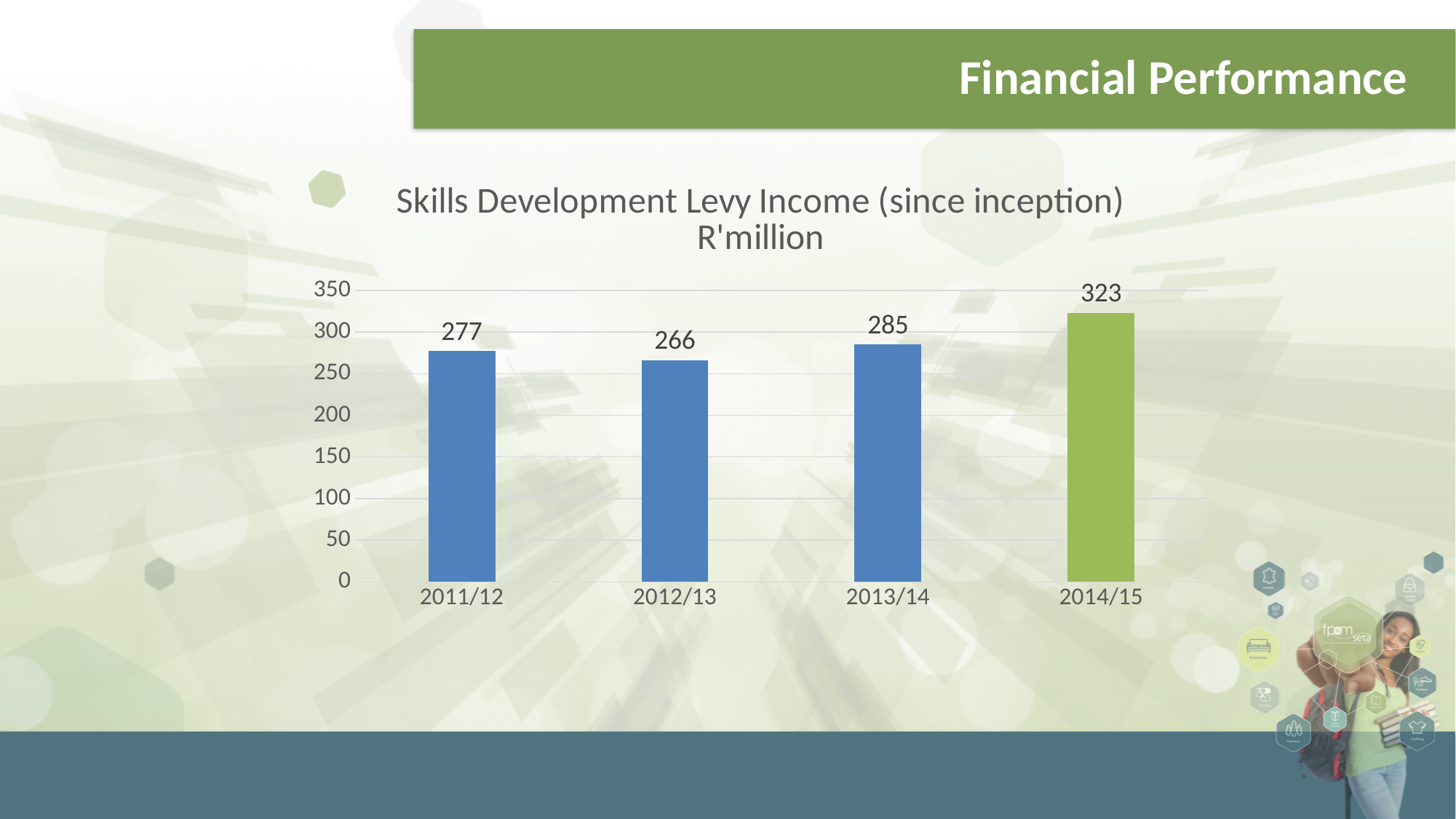
What unit is stated in the chart title? R'million Which year has the highest Skills Development Levy Income? 2014/15 Which is larger, the Skills Development Levy Income for 2011/12 or 2012/13? 2011/12 How many years are shown on the chart? 4 What is the Skills Development Levy Income for 2011/12? 277 What is the Skills Development Levy Income for 2014/15? 323 What is the Skills Development Levy Income for 2012/13? 266 What kind of chart is shown on the slide? Bar chart What is the difference between the Skills Development Levy Income for 2014/15 and 2013/14? 38 What is the Skills Development Levy Income for 2013/14? 285 Is the value for 2014/15 greater or less than 300? greater Which year has the lowest Skills Development Levy Income? 2012/13